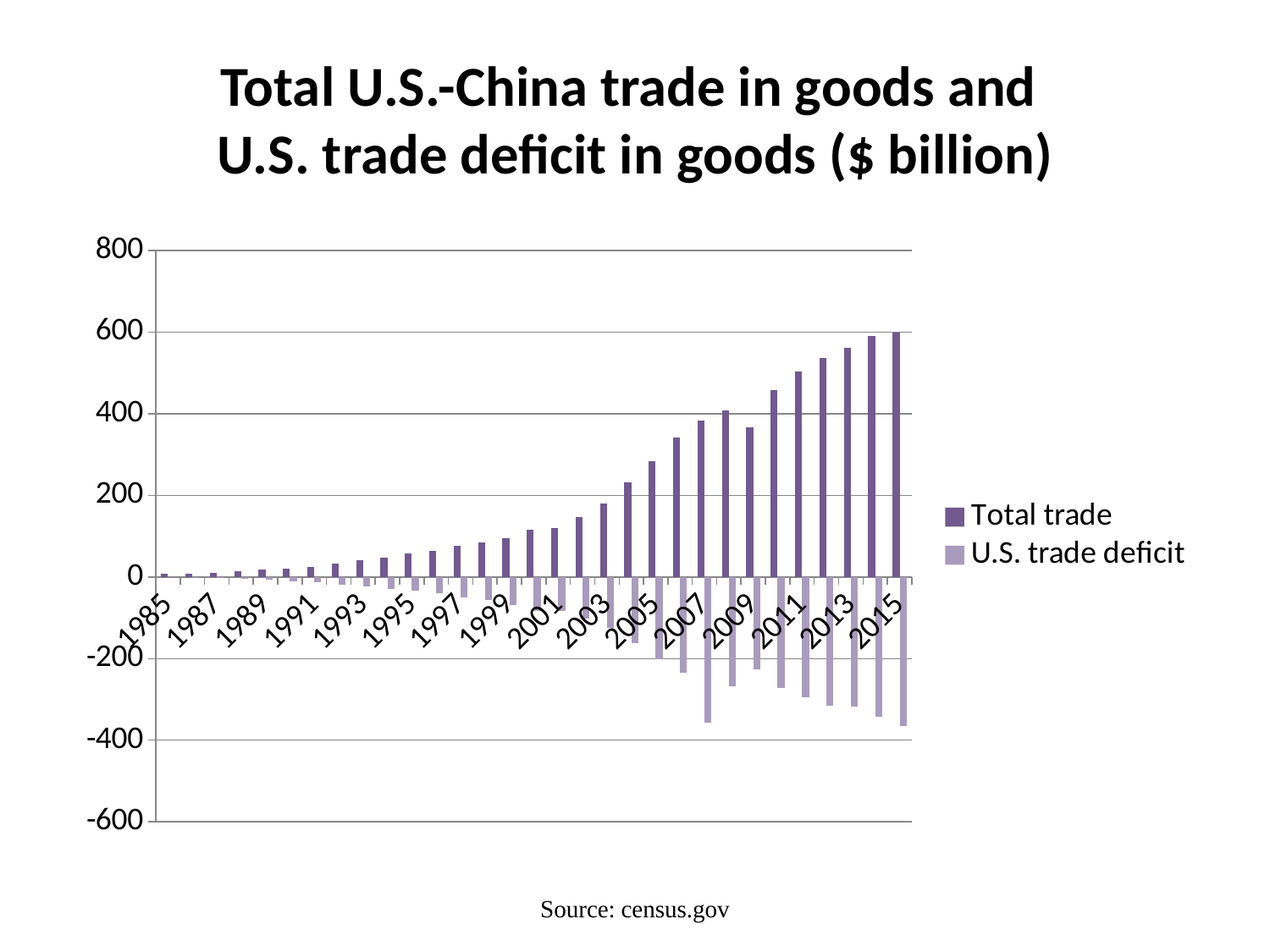
What are the two series named in the legend? Total trade and U.S. trade deficit Is the U.S. trade deficit value for 2015 greater or less than -200? less Is the Total trade value for 2001 greater or less than 200? less In which year is Total trade highest? 2015 Does Total trade generally rise or fall from 1985 to 2015? rise How many years are plotted on the x axis, from 1985 to 2015? 31 What source is cited below the chart? census.gov Which is larger, Total trade in 2008 or Total trade in 2009? 2008 How many series does the legend list? 2 What kind of chart is shown on the slide? bar chart Is the Total trade value for 2015 greater or less than 400? greater